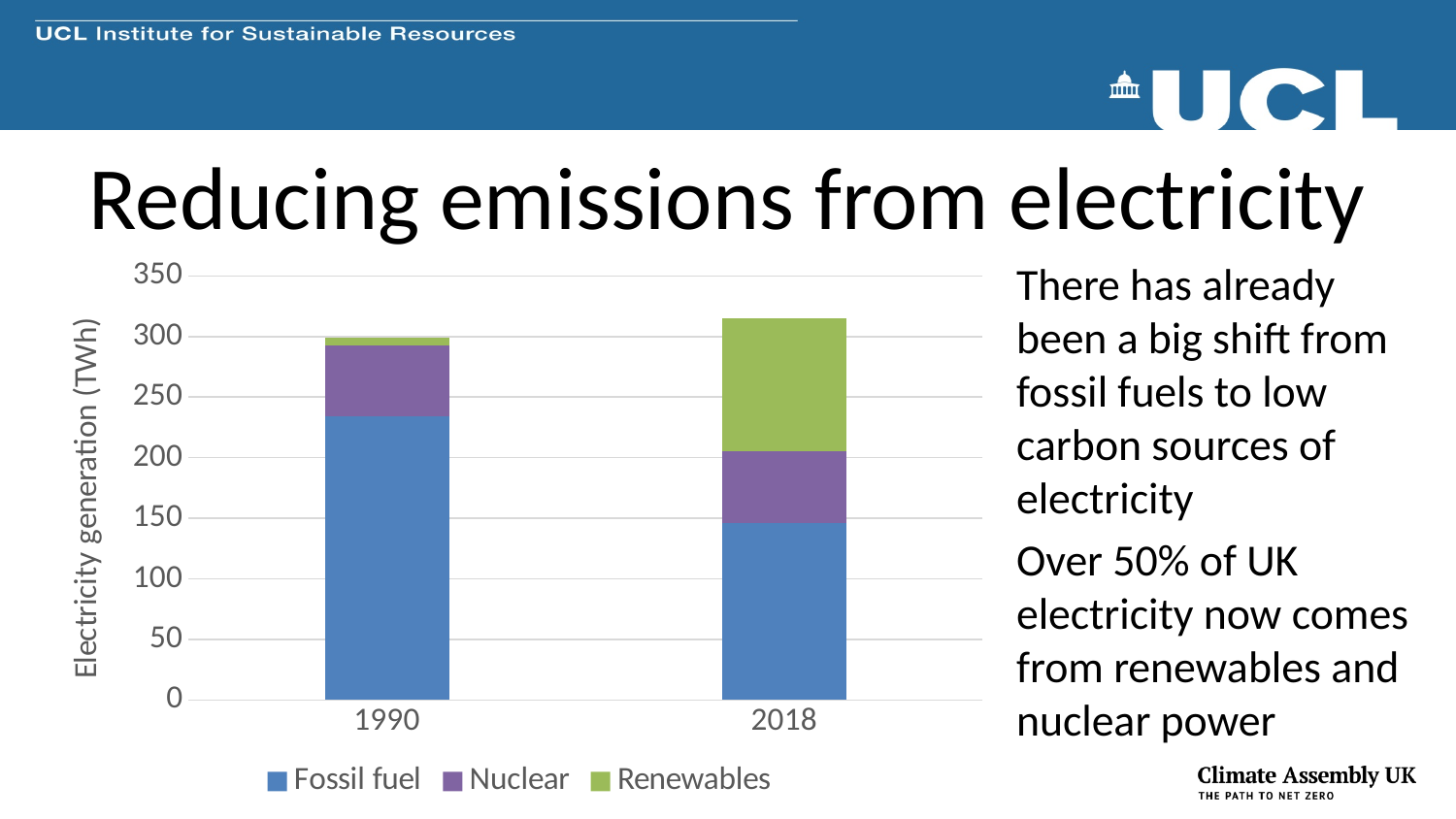
Is the total electricity generation for 2018 greater or less than 300? greater What is the label of the vertical axis? Electricity generation (TWh) Which year has the larger Renewables value, 1990 or 2018? 2018 How many years (categories) are shown on the x axis? 2 Is the Renewables value for 1990 greater or less than 50? less Is the Fossil fuel value for 2018 greater or less than 100? greater Which year has the larger Fossil fuel value, 1990 or 2018? 1990 How many series does the legend list? 3 Which series are listed in the legend? Fossil fuel, Nuclear, Renewables What kind of chart is shown on the slide? Stacked bar chart Does the Fossil fuel value rise or fall from 1990 to 2018? fall